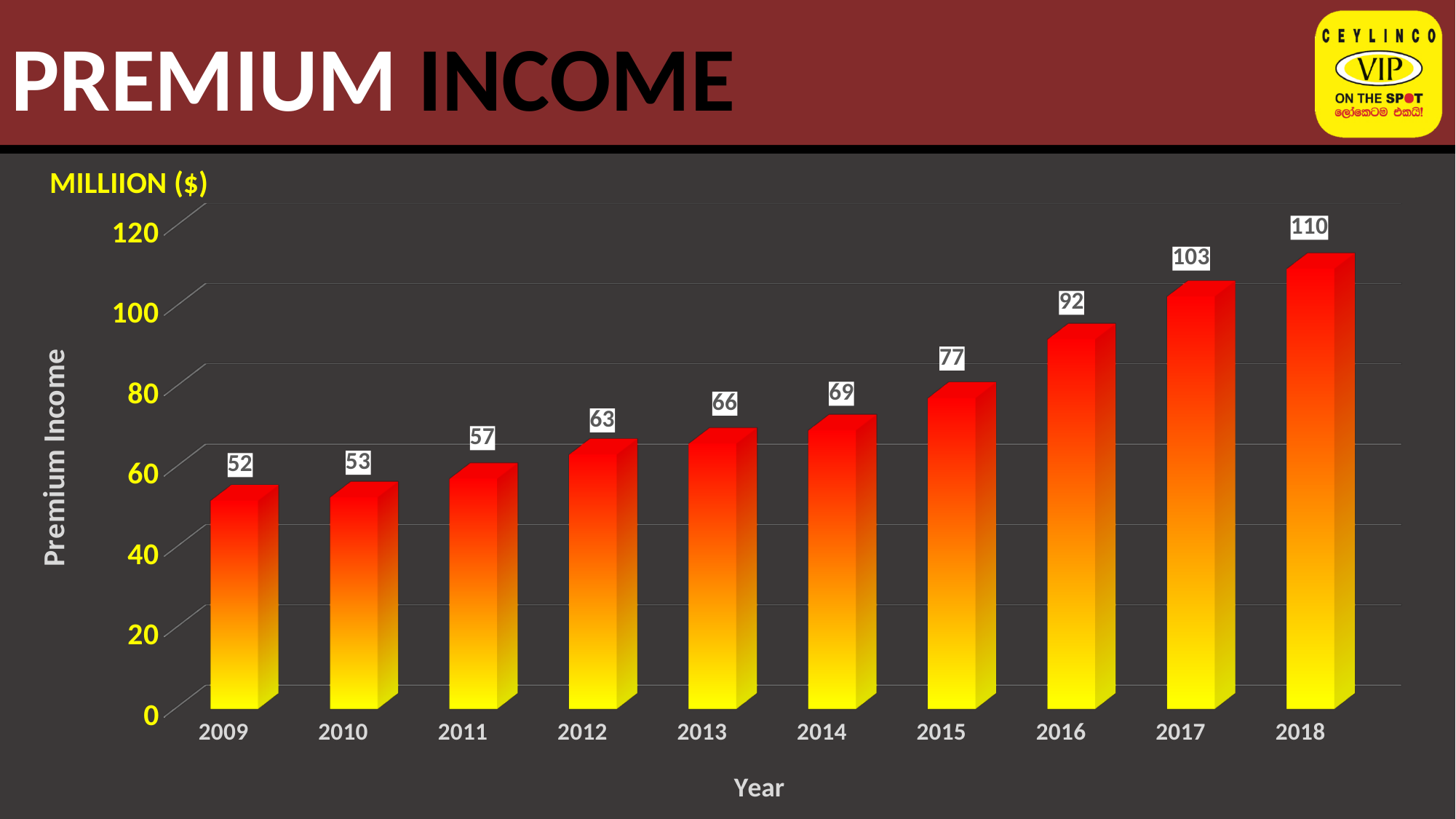
Which year has a larger premium income, 2013 or 2014? 2014 What is the premium income for 2009? 52 Is the premium income for 2017 greater or less than 100? greater What is the premium income for 2016? 92 Which year has the highest premium income? 2018 What is the difference in premium income between 2015 and 2011? 20 Which year has the lowest premium income? 2009 What is the difference in premium income between 2018 and 2017? 7 What kind of chart is shown on the slide? Bar chart Does premium income rise or fall from 2009 to 2018? Rise How many years are shown on the chart? 10 What is the premium income for 2012? 63